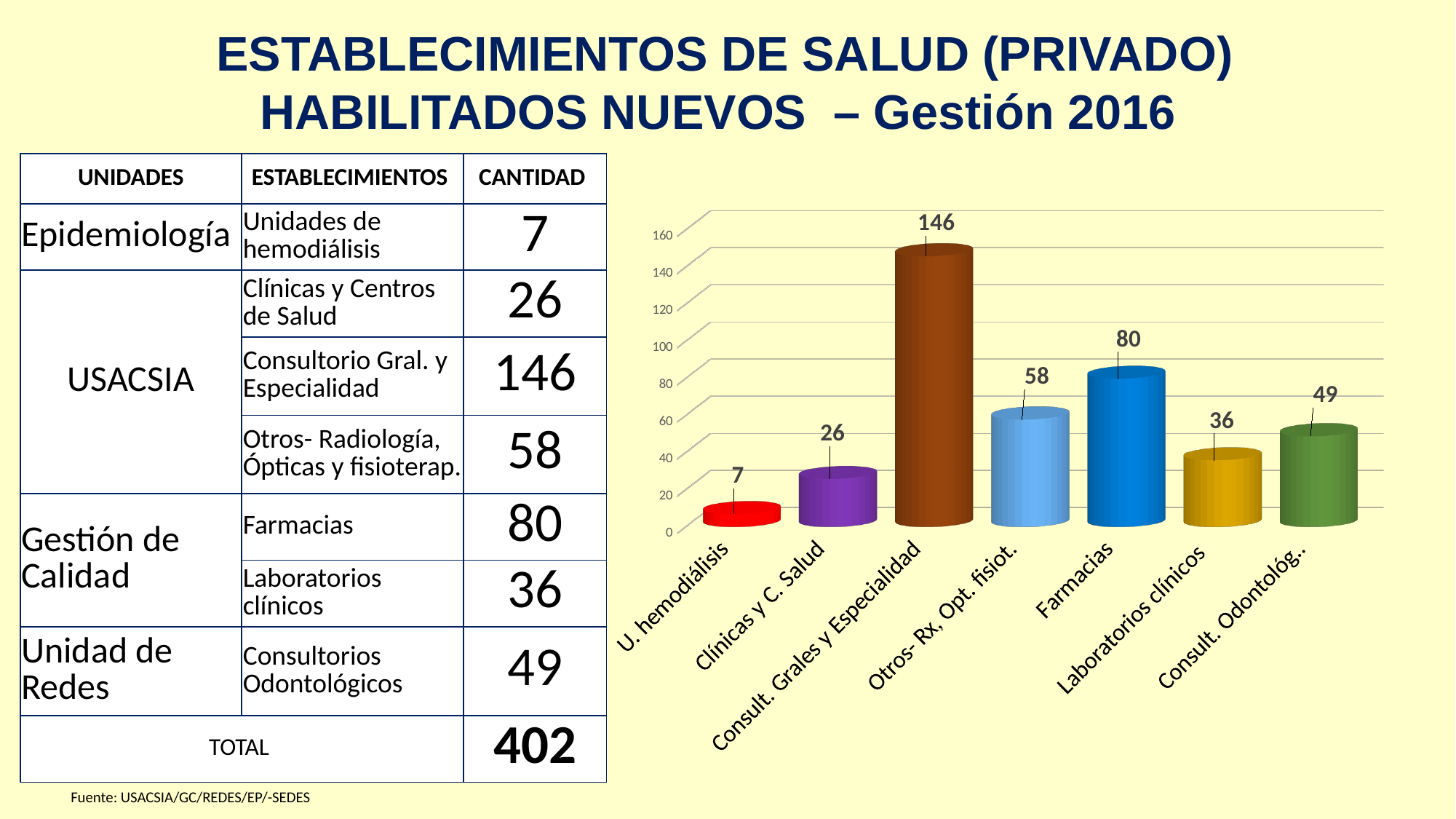
What colour is the bar for Consult. Grales y Especialidad? brown Which category has the highest value in the chart? Consult. Grales y Especialidad What is the value for Farmacias in the chart? 80 Which is larger, the value for Consult. Odontológ. or the value for Laboratorios clínicos? Consult. Odontológ. What is the difference between the values for Consult. Grales y Especialidad and Clínicas y C. Salud? 120 What is the value for Consult. Odontológ. in the chart? 49 What kind of chart is shown on the slide? bar chart What is the difference between the values for Farmacias and Otros- Rx, Opt. fisiot.? 22 How many categories are shown in the chart? 7 Which category has the lowest value in the chart? U. hemodiálisis Is the value for Otros- Rx, Opt. fisiot. greater or less than 40? greater What is the value for Laboratorios clínicos in the chart? 36